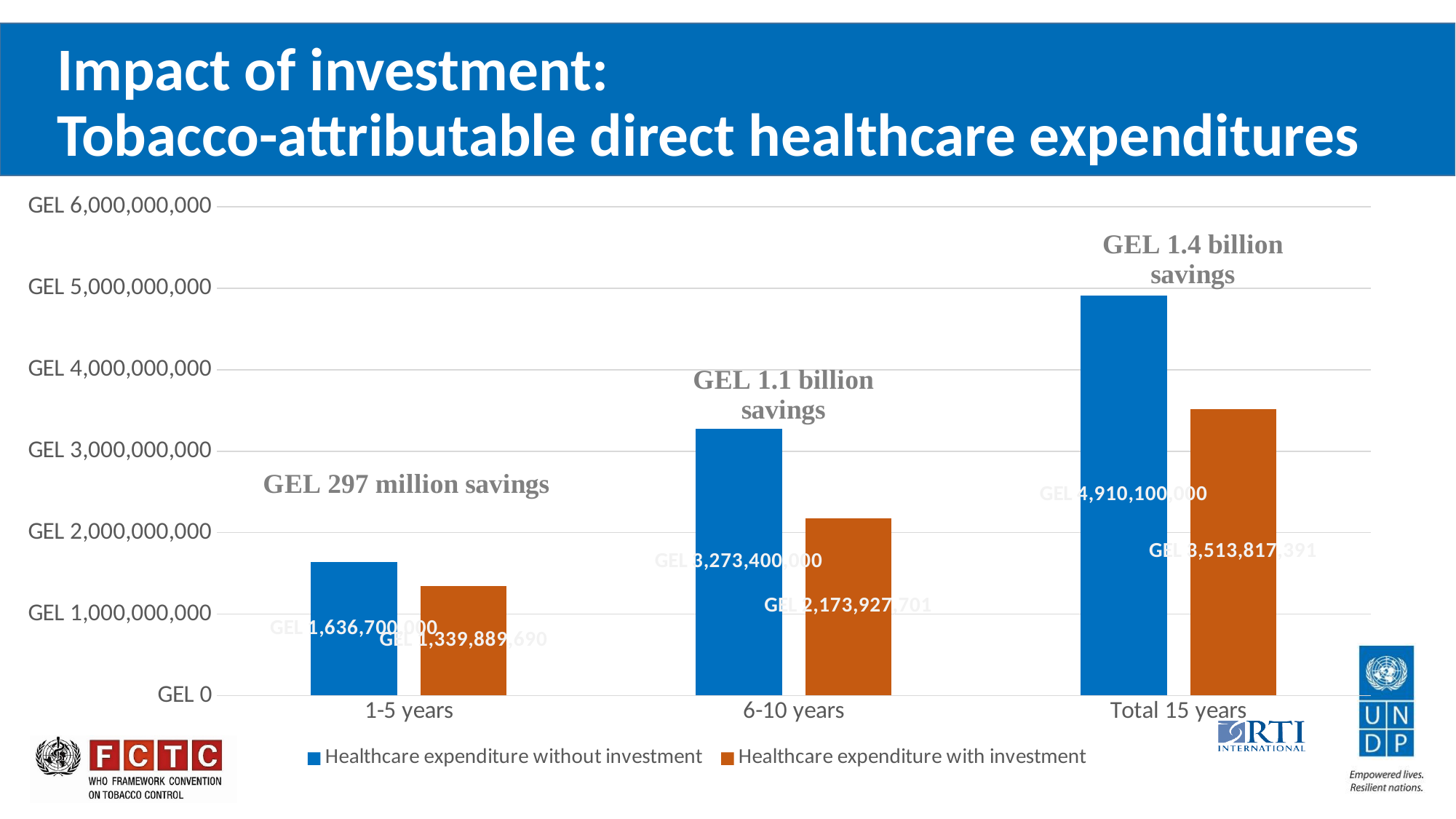
For 6-10 years, which is larger: healthcare expenditure without investment or with investment? Healthcare expenditure without investment How many categories are shown on the x axis? 3 What is the healthcare expenditure without investment for Total 15 years? GEL 4,910,100,000 What kind of chart is shown on the slide? Bar chart How many series does the legend list? 2 What is the healthcare expenditure without investment for 6-10 years? GEL 3,273,400,000 Is the healthcare expenditure with investment for Total 15 years greater or less than GEL 3,000,000,000? greater What savings are annotated above the bars for Total 15 years? GEL 1.4 billion savings What savings are annotated above the bars for 1-5 years? GEL 297 million savings Which category has the highest healthcare expenditure without investment? Total 15 years What savings are annotated above the bars for 6-10 years? GEL 1.1 billion savings Which category has the lowest healthcare expenditure with investment? 1-5 years